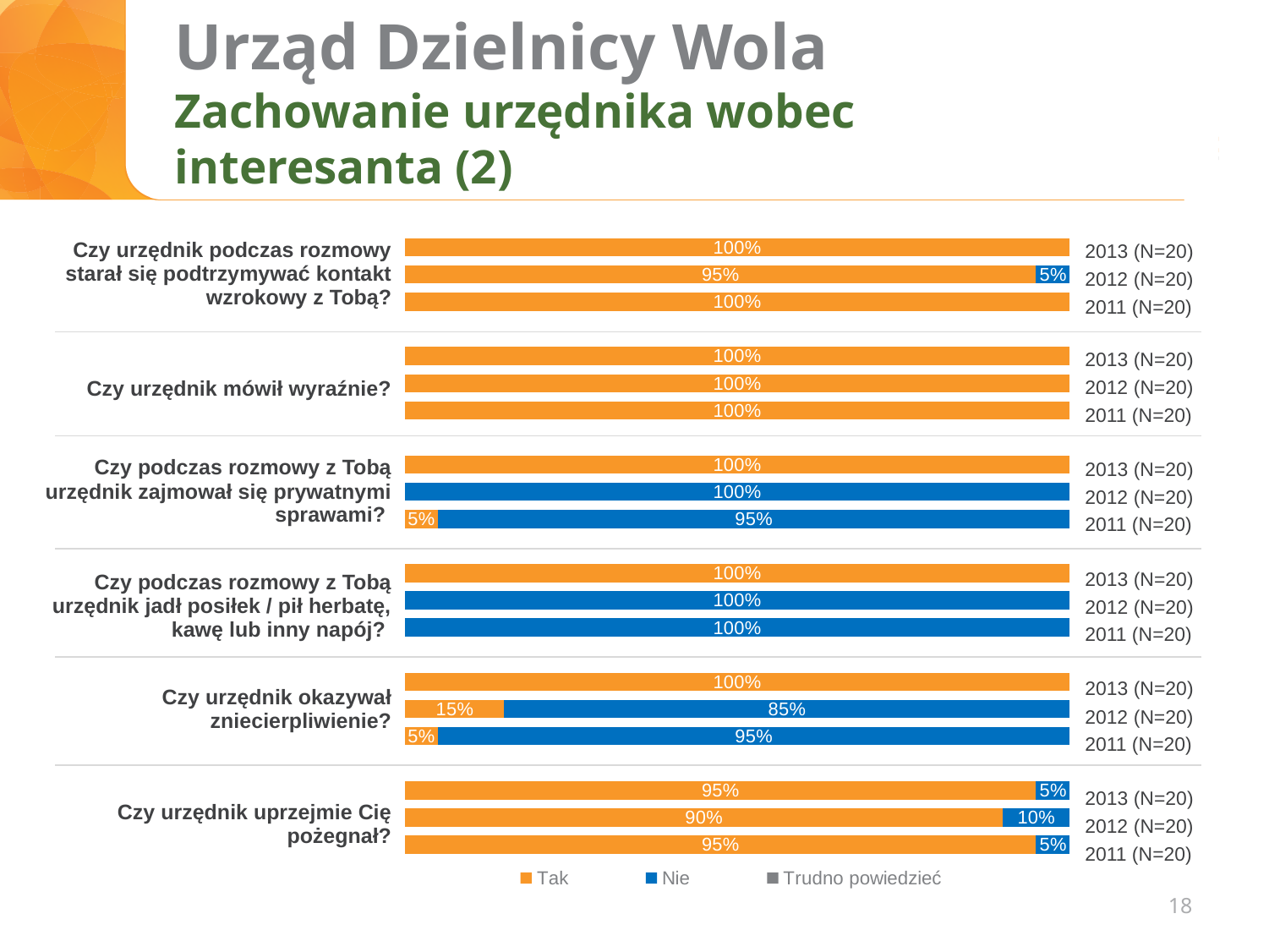
What kind of chart is shown on the slide? Bar chart What is the total of the stacked bar for 2012 (N=20) in the question "Czy urzędnik uprzejmie Cię pożegnał?"? 100% What is the value of "Tak" for 2012 (N=20) in the question "Czy urzędnik uprzejmie Cię pożegnał?"? 90% What are the legend entries of the chart? Tak, Nie, Trudno powiedzieć What is the value of "Nie" for 2012 (N=20) in the question "Czy urzędnik okazywał zniecierpliwienie?"? 85% In the question "Czy urzędnik uprzejmie Cię pożegnał?", what is the difference between the "Tak" value for 2013 (N=20) and for 2012 (N=20)? 5 percentage points What is the value of "Tak" for 2012 (N=20) in the question "Czy urzędnik okazywał zniecierpliwienie?"? 15% In the question "Czy urzędnik okazywał zniecierpliwienie?", which year has the larger "Nie" value, 2012 (N=20) or 2011 (N=20)? 2011 (N=20) How many series does the legend list? 3 What is the value of "Tak" for 2011 (N=20) in the question "Czy urzędnik mówił wyraźnie?"? 100% What is the value of "Nie" for 2012 (N=20) in the question "Czy urzędnik podczas rozmowy starał się podtrzymywać kontakt wzrokowy z Tobą?"? 5% How many survey questions are shown in the chart? 6